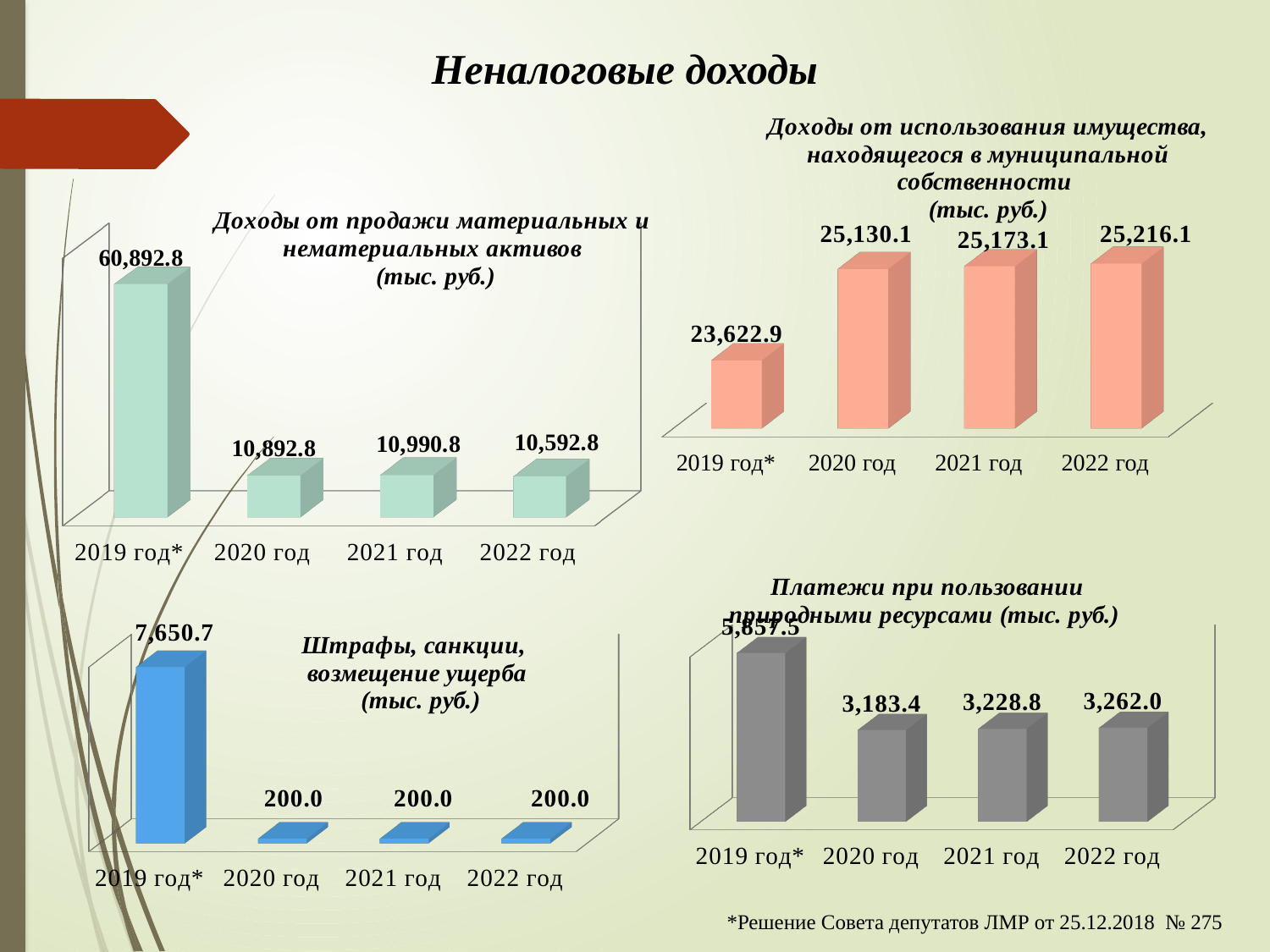
In the chart 'Доходы от продажи материальных и нематериальных активов', which year has the lowest value? 2022 год What type of chart is 'Штрафы, санкции, возмещение ущерба'? bar chart In the chart 'Доходы от продажи материальных и нематериальных активов', what is the value for 2019 год*? 60,892.8 In the chart 'Платежи при пользовании природными ресурсами', what is the value for 2020 год? 3,183.4 In the chart 'Штрафы, санкции, возмещение ущерба', what is the value for 2021 год? 200.0 In the chart 'Доходы от использования имущества, находящегося в муниципальной собственности', which year has the lowest value? 2019 год* In the chart 'Штрафы, санкции, возмещение ущерба', what is the value for 2019 год*? 7,650.7 In the chart 'Платежи при пользовании природными ресурсами', which is larger, the value for 2021 год or 2022 год? 2022 год In the chart 'Доходы от использования имущества, находящегося в муниципальной собственности', do the values rise or fall from 2019 to 2022? rise How many years are shown in the chart 'Платежи при пользовании природными ресурсами'? 4 In the chart 'Доходы от продажи материальных и нематериальных активов', what is the difference between the 2021 год and 2022 год values? 398.0 In the chart 'Доходы от использования имущества, находящегося в муниципальной собственности', what is the value for 2022 год? 25,216.1